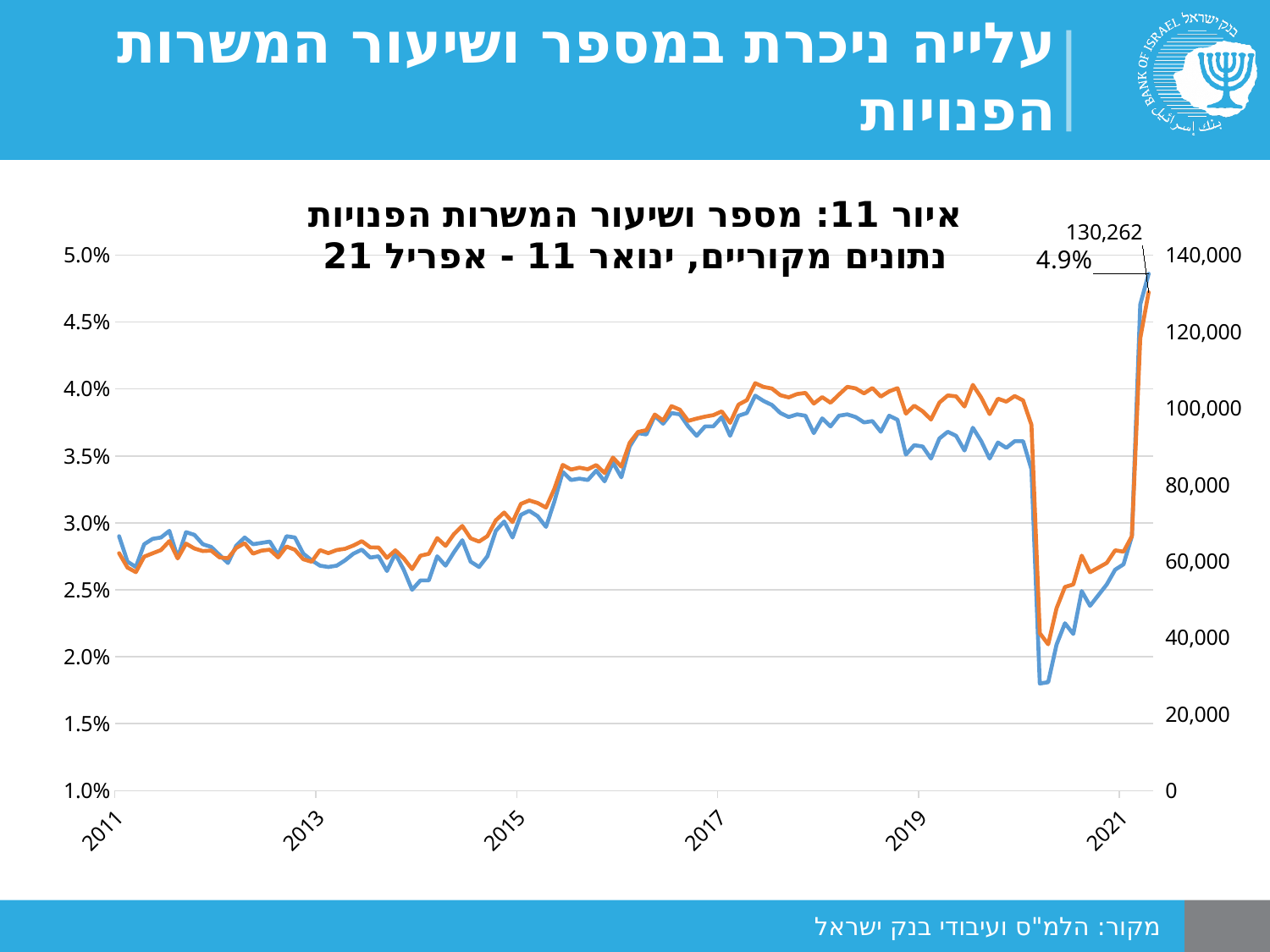
What kind of chart is shown on the slide? line chart What is the highest value shown on the right-hand vertical axis? 140,000 How many lines are plotted on the chart? 2 Is the labelled final value of 130,262 greater or less than 120,000 on the right axis? greater What is the first year shown on the horizontal axis? 2011 What is the last year labelled on the horizontal axis? 2021 Do the plotted lines rise or fall sharply in the final months shown, approaching April 2021? rise What is the number of job vacancies labelled at the end of the series (April 2021)? 130,262 What is the lowest value shown on the left-hand vertical axis? 1.0% Is the labelled final rate of 4.9% greater or less than 4.5% on the left axis? greater Do the plotted lines generally rise or fall between 2013 and 2017? rise What is the job vacancy rate labelled at the end of the series (April 2021)? 4.9%